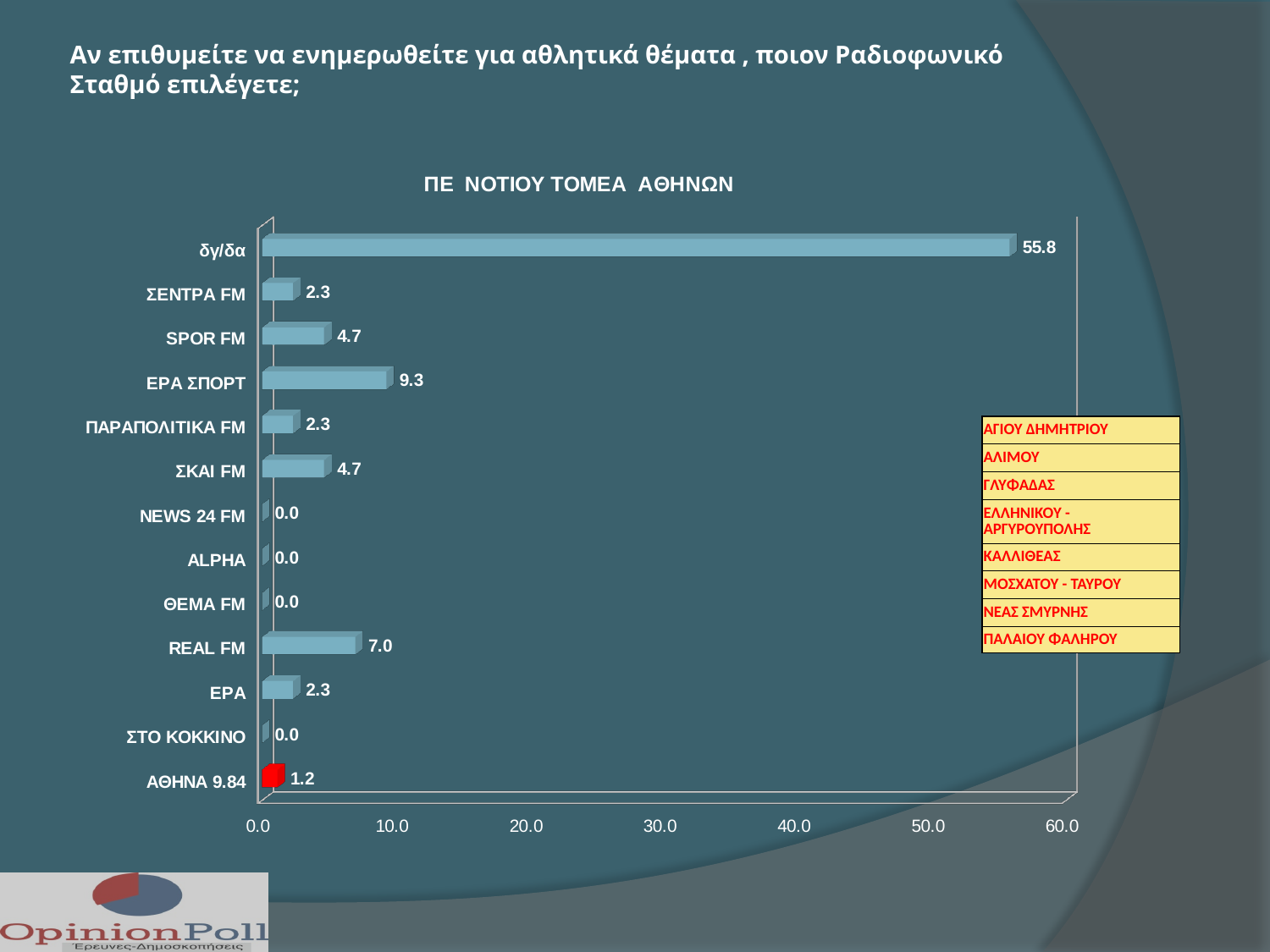
What is the value for REAL FM? 7.0 Is the value for δγ/δα greater or less than 50.0? greater What is the title of the chart? ΠΕ ΝΟΤΙΟΥ ΤΟΜΕΑ ΑΘΗΝΩΝ Which is larger, the value for SPOR FM or the value for ΣΕΝΤΡΑ FM? SPOR FM Which category has the highest value? δγ/δα How many categories are shown on the chart? 13 Excluding δγ/δα, which radio station has the highest value? ΕΡΑ ΣΠΟΡΤ What is the value for ΑΘΗΝΑ 9.84? 1.2 What kind of chart is shown on the slide? bar chart What is the difference between the values for ΕΡΑ ΣΠΟΡΤ and REAL FM? 2.3 What is the value for ΕΡΑ ΣΠΟΡΤ? 9.3 What is the value for δγ/δα? 55.8